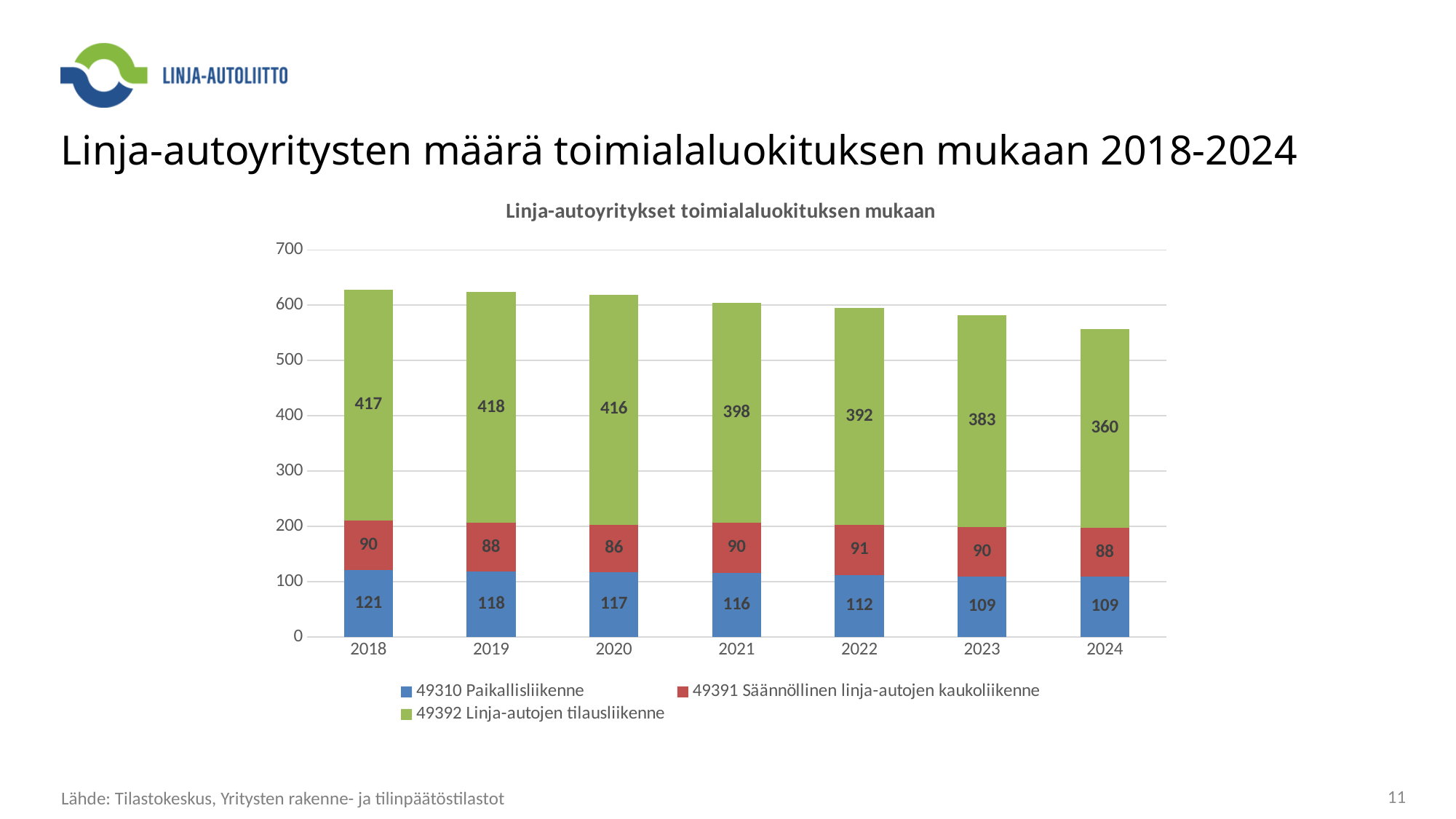
What is the value for 49310 Paikallisliikenne in 2018? 121 What is the total of the stacked bar for 2018? 628 In which year is the value for 49392 Linja-autojen tilausliikenne lowest? 2024 What is the difference between the 49392 Linja-autojen tilausliikenne values for 2018 and 2024? 57 What kind of chart is shown on the slide? Stacked bar chart What is the value for 49392 Linja-autojen tilausliikenne in 2024? 360 How many series does the legend list? 3 In which year is the value for 49392 Linja-autojen tilausliikenne highest? 2019 What is the value for 49391 Säännöllinen linja-autojen kaukoliikenne in 2022? 91 What is the total of the stacked bar for 2024? 557 How many years are shown on the x axis? 7 Which is larger, the 49310 Paikallisliikenne value for 2019 or for 2022? 2019